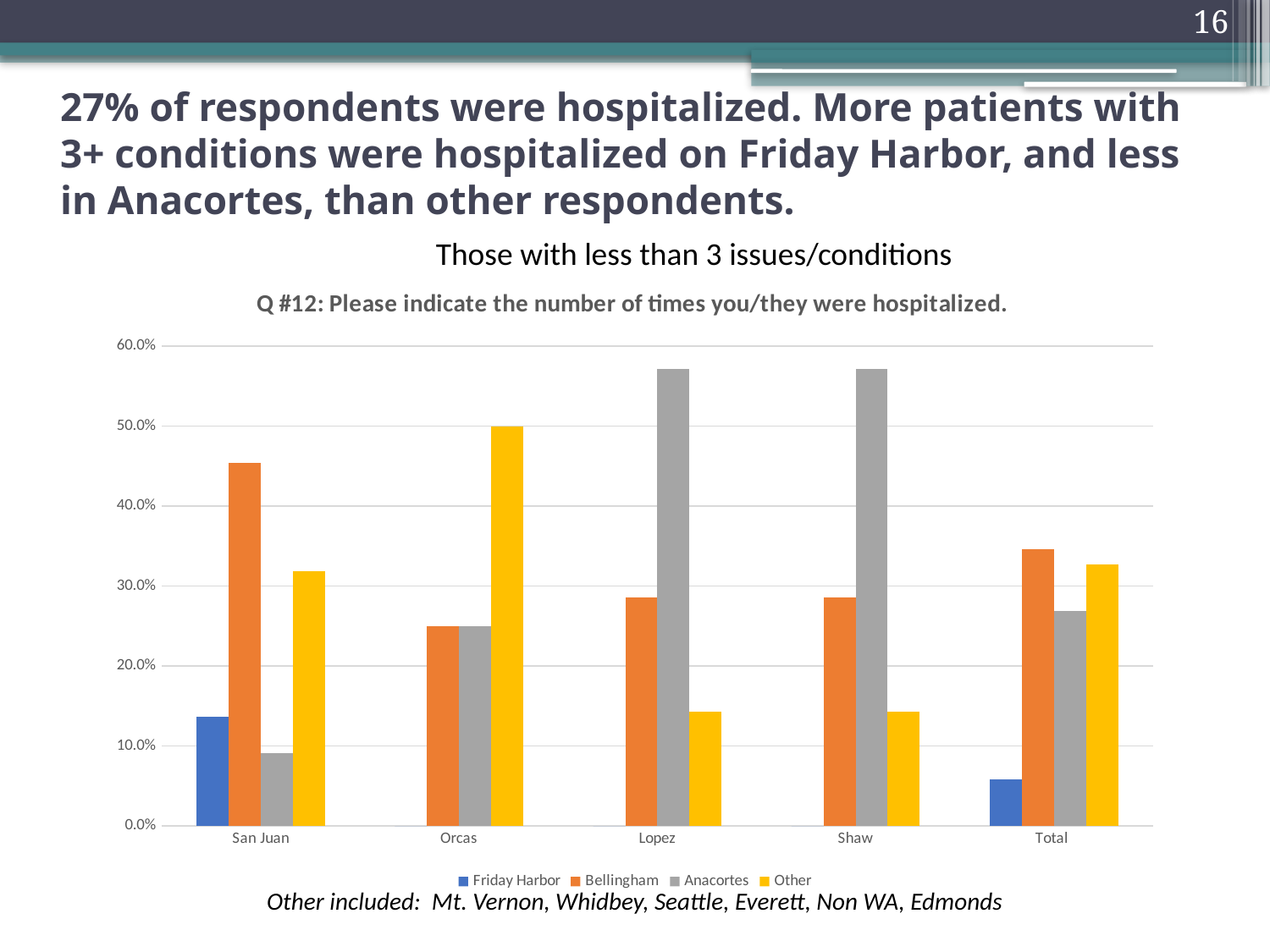
What kind of chart is shown on the slide? bar chart How many categories are shown along the x axis of the chart? 5 Which series has the lowest value in the Total category? Friday Harbor Is the value for Bellingham in the San Juan category greater or less than 40.0%? greater How many series does the chart legend list? 4 Is the value for Friday Harbor in the Total category greater or less than 10.0%? less What is the value for Other in the Orcas category? 50.0% Which series has the highest value in the Lopez category? Anacortes Which series has the highest value in the San Juan category? Bellingham In the San Juan category, which is larger: the value for Bellingham or the value for Other? Bellingham What is the title of the chart? Q #12: Please indicate the number of times you/they were hospitalized. Is the value for Anacortes in the Shaw category greater or less than 50.0%? greater